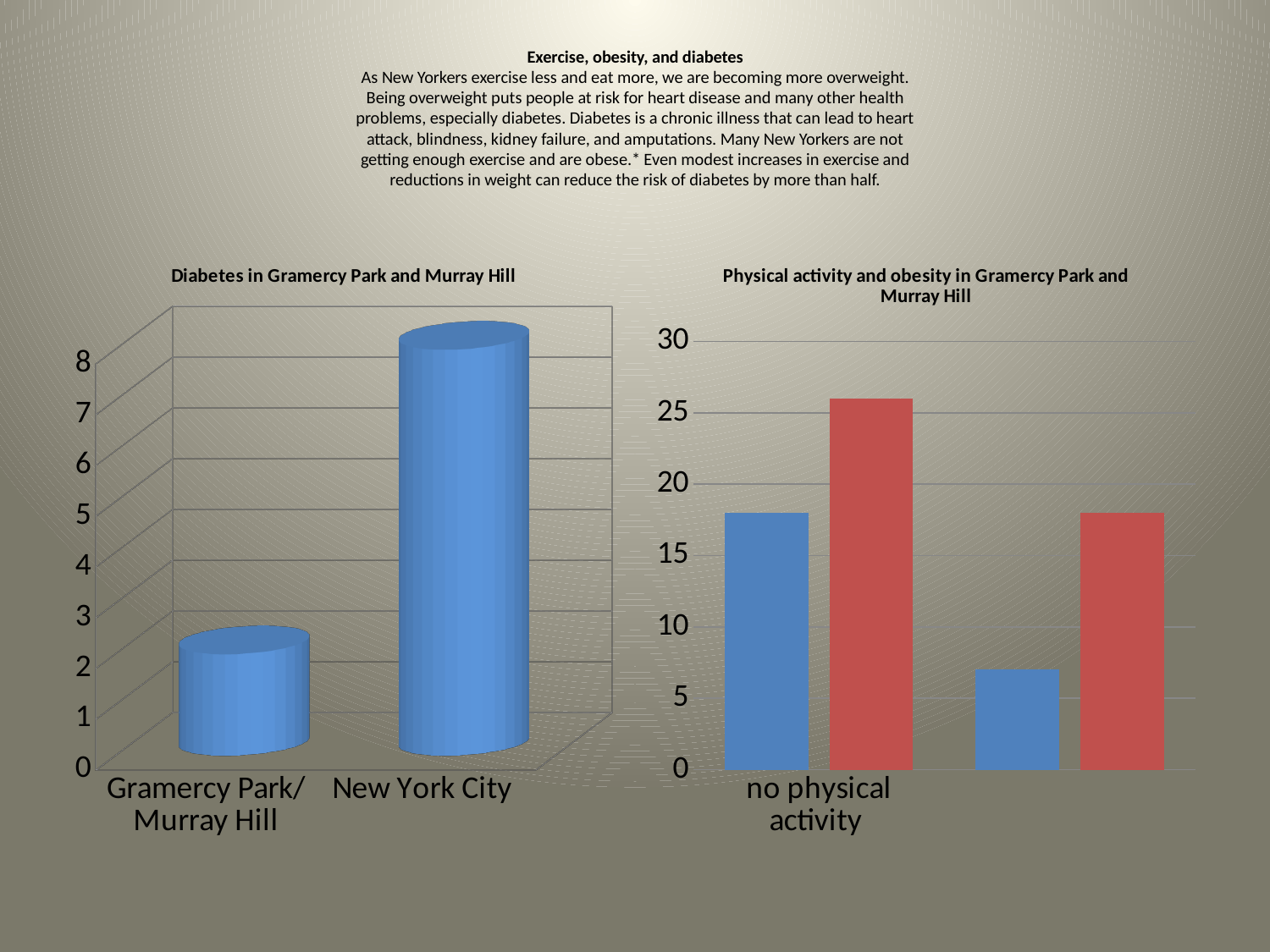
What kind of chart is the 'Physical activity and obesity in Gramercy Park and Murray Hill' chart? bar chart In the 'Physical activity and obesity in Gramercy Park and Murray Hill' chart, is the red bar for 'no physical activity' greater or less than 20? greater In the 'Diabetes in Gramercy Park and Murray Hill' chart, is the value for Gramercy Park/Murray Hill greater or less than 4? less How many categories are shown in the 'Diabetes in Gramercy Park and Murray Hill' chart? 2 In the 'Diabetes in Gramercy Park and Murray Hill' chart, which is larger, the value for Gramercy Park/Murray Hill or the value for New York City? New York City What kind of chart is the 'Diabetes in Gramercy Park and Murray Hill' chart? bar chart In the 'Diabetes in Gramercy Park and Murray Hill' chart, is the value for New York City greater or less than 6? greater What is the title of the chart on the left side of the slide? Diabetes in Gramercy Park and Murray Hill In the 'Physical activity and obesity in Gramercy Park and Murray Hill' chart, which bar is taller for 'no physical activity', the blue bar or the red bar? the red bar In the 'Diabetes in Gramercy Park and Murray Hill' chart, which category has the lowest value? Gramercy Park/Murray Hill In the 'Diabetes in Gramercy Park and Murray Hill' chart, which category has the highest value? New York City